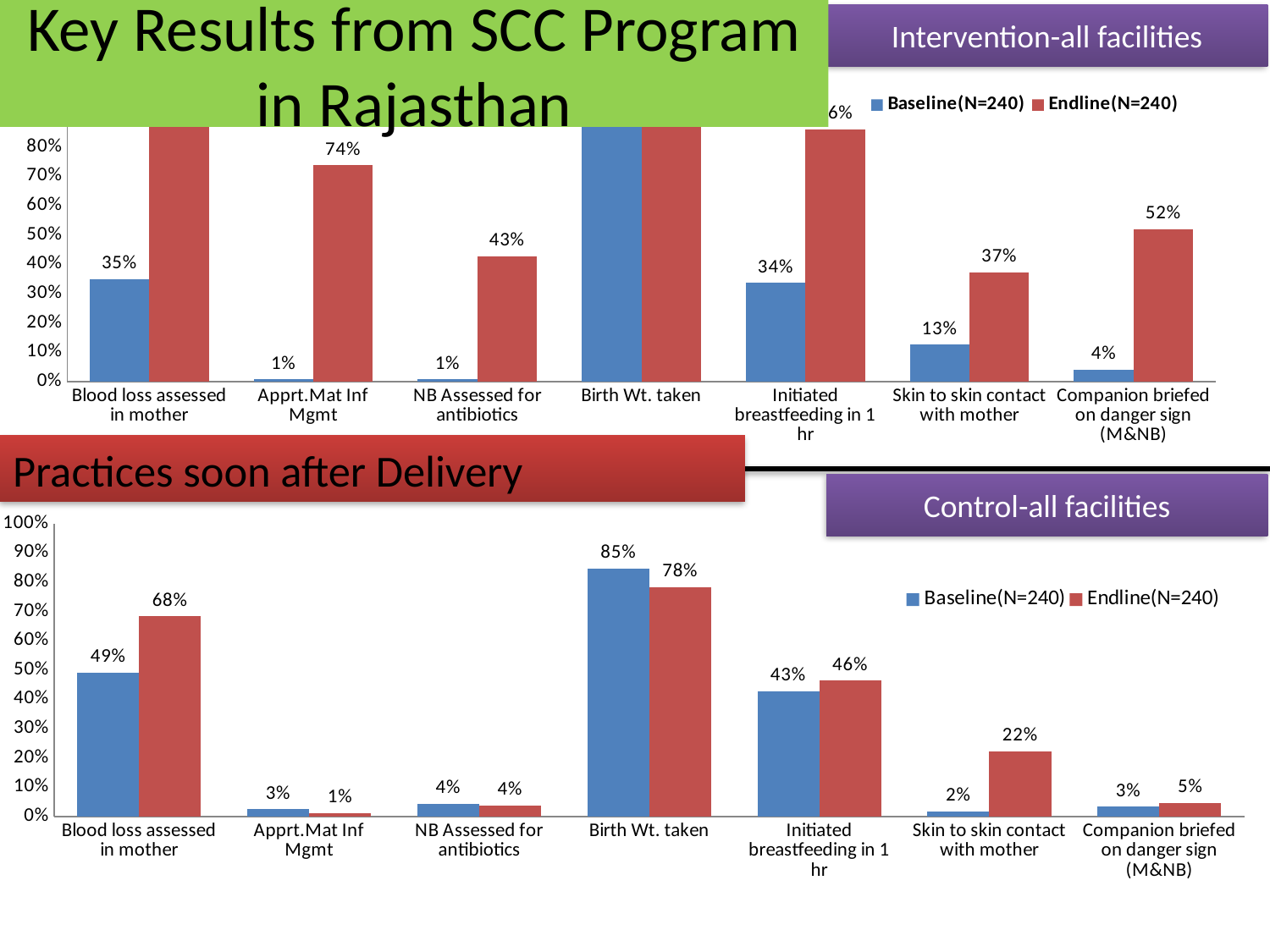
How many series does the legend of the Intervention-all facilities chart list? 2 In the Intervention-all facilities chart, is the Endline value for Blood loss assessed in mother greater or less than 80%? greater In the Intervention-all facilities chart, which category has the lowest Endline value? Skin to skin contact with mother In the Control-all facilities chart, which is larger for Initiated breastfeeding in 1 hr: Baseline or Endline? Endline In the Intervention-all facilities chart, what is the Baseline value for Skin to skin contact with mother? 13% What type of chart is the Control-all facilities chart? Bar chart How many categories are shown on the x axis of the Control-all facilities chart? 7 In the Control-all facilities chart, which category has the highest Endline value? Birth Wt. taken In the Control-all facilities chart, what is the difference between the Endline and Baseline values for Skin to skin contact with mother? 20% In the Intervention-all facilities chart, what is the Endline value for Apprt.Mat Inf Mgmt? 74% In the Control-all facilities chart, what is the Baseline value for Birth Wt. taken? 85% In the Intervention-all facilities chart, what is the difference between the Endline and Baseline values for Companion briefed on danger sign (M&NB)? 48%